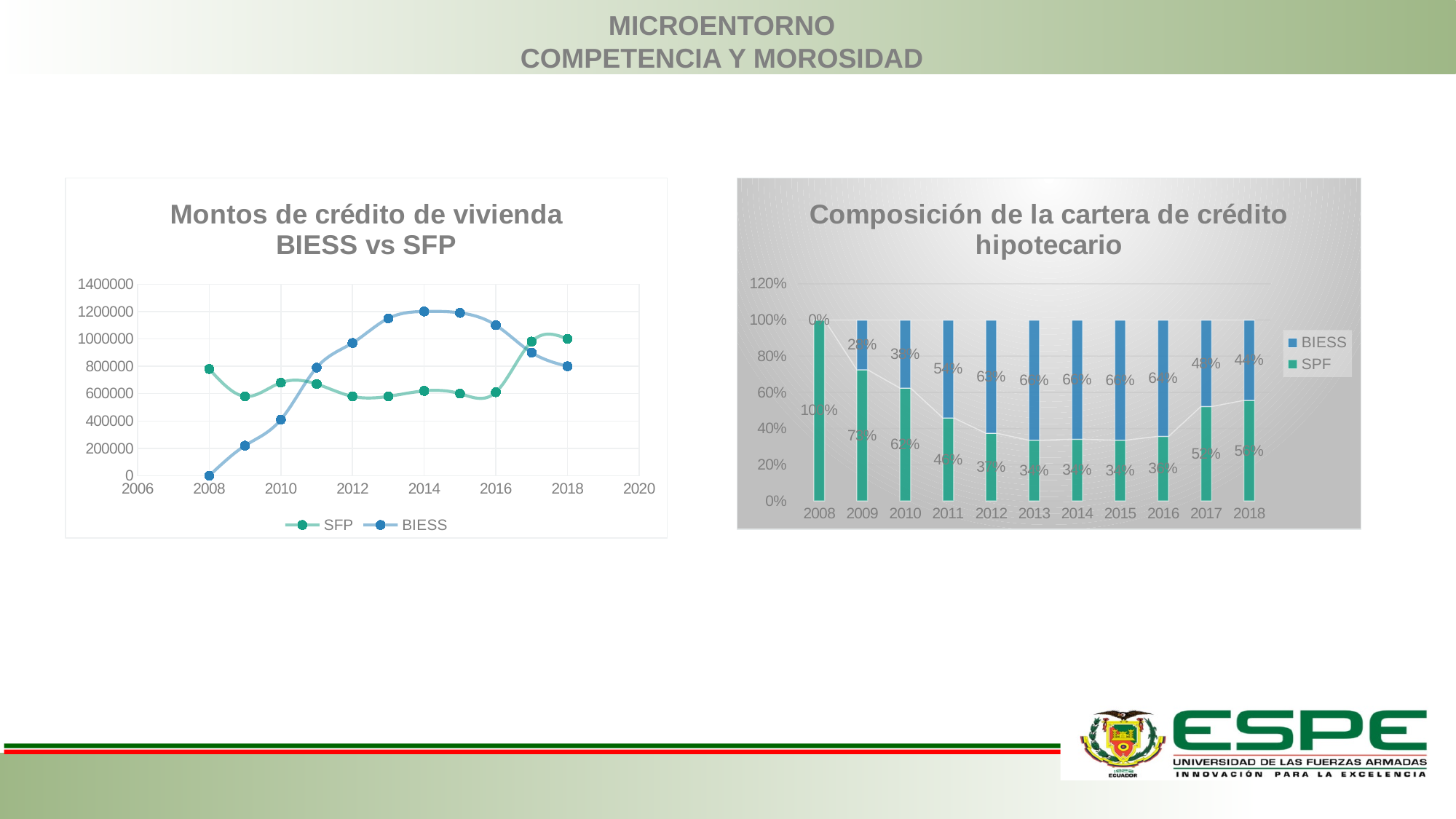
What kind of chart is the 'Composición de la cartera de crédito hipotecario' chart? Stacked bar chart In the 'Composición de la cartera de crédito hipotecario' chart, what is the SPF share for 2008? 100% In the 'Montos de crédito de vivienda BIESS vs SFP' chart, is the SFP value for 2012 greater or less than 800000? less What kind of chart is the 'Montos de crédito de vivienda BIESS vs SFP' chart? Line chart In the 'Composición de la cartera de crédito hipotecario' chart, what is the difference between the BIESS share and the SPF share in 2012? 26 percentage points In the 'Montos de crédito de vivienda BIESS vs SFP' chart, is the BIESS value for 2008 greater or less than 200000? less How many years are shown on the x axis of the 'Composición de la cartera de crédito hipotecario' chart? 11 How many series does the legend of the 'Montos de crédito de vivienda BIESS vs SFP' chart list? 2 In the 'Montos de crédito de vivienda BIESS vs SFP' chart, is the BIESS value for 2014 greater or less than 1000000? greater In the 'Montos de crédito de vivienda BIESS vs SFP' chart, which series has the higher value in 2014, SFP or BIESS? BIESS In the 'Composición de la cartera de crédito hipotecario' chart, what is the BIESS share for 2011? 54% In the 'Montos de crédito de vivienda BIESS vs SFP' chart, does the BIESS series rise or fall from 2008 to 2014? Rises